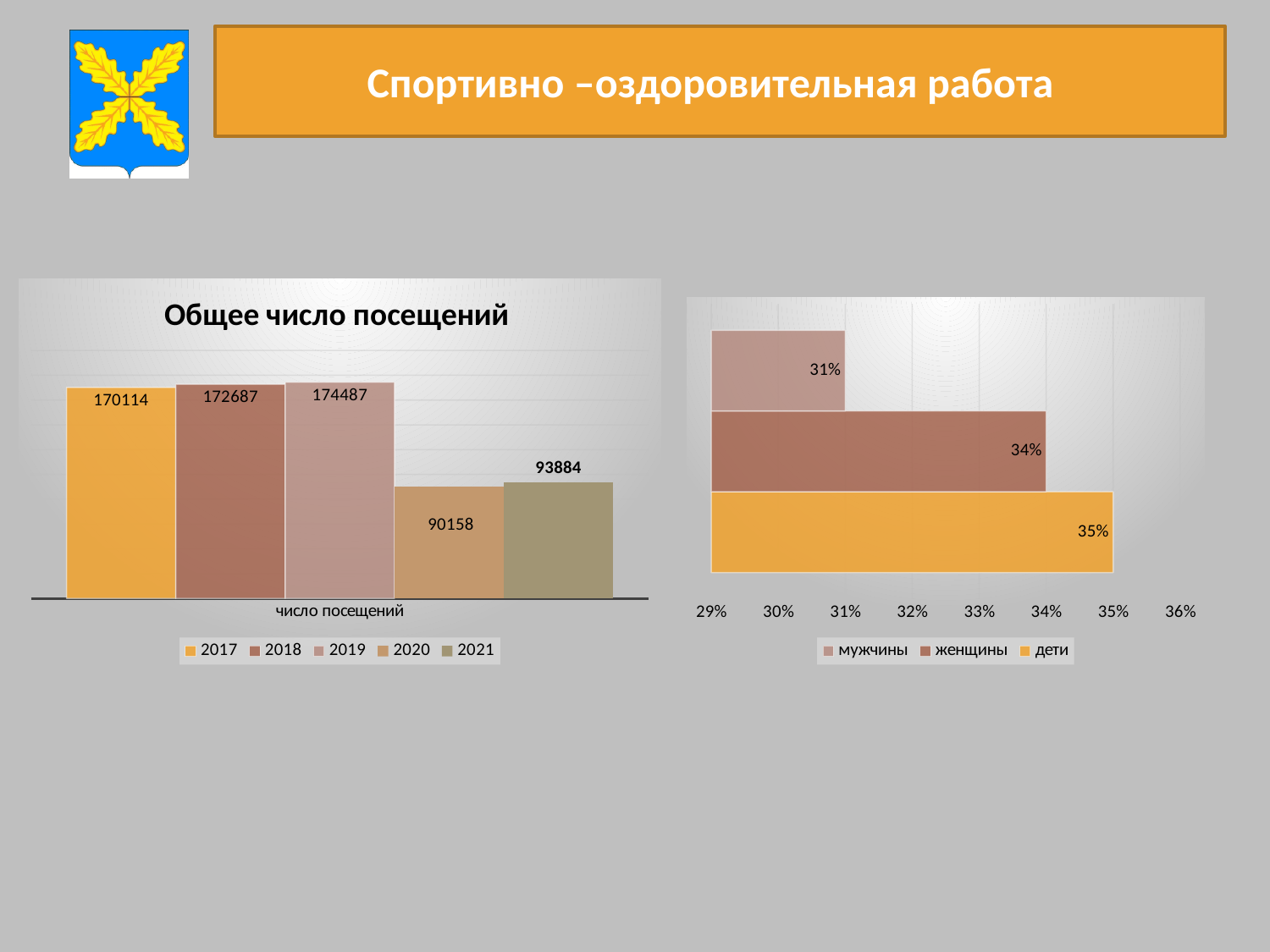
In the chart titled "Общее число посещений", what is the difference between the values for 2018 and 2017? 2573 In the chart titled "Общее число посещений", which year has the highest value? 2019 What kind of chart is the chart on the right side of the slide? bar chart How many series does the legend of the chart on the right side of the slide list? 3 In the chart titled "Общее число посещений", which is larger, the value for 2021 or the value for 2020? 2021 How many series does the legend of the chart titled "Общее число посещений" list? 5 In the chart titled "Общее число посещений", what is the value for 2019? 174487 In the chart titled "Общее число посещений", which year has the lowest value? 2020 In the chart on the right side of the slide, what is the value for женщины? 34% In the chart on the right side of the slide, what is the difference between the values for дети and мужчины? 4% In the chart titled "Общее число посещений", what is the value for 2020? 90158 In the chart on the right side of the slide, which series has the lowest value? мужчины